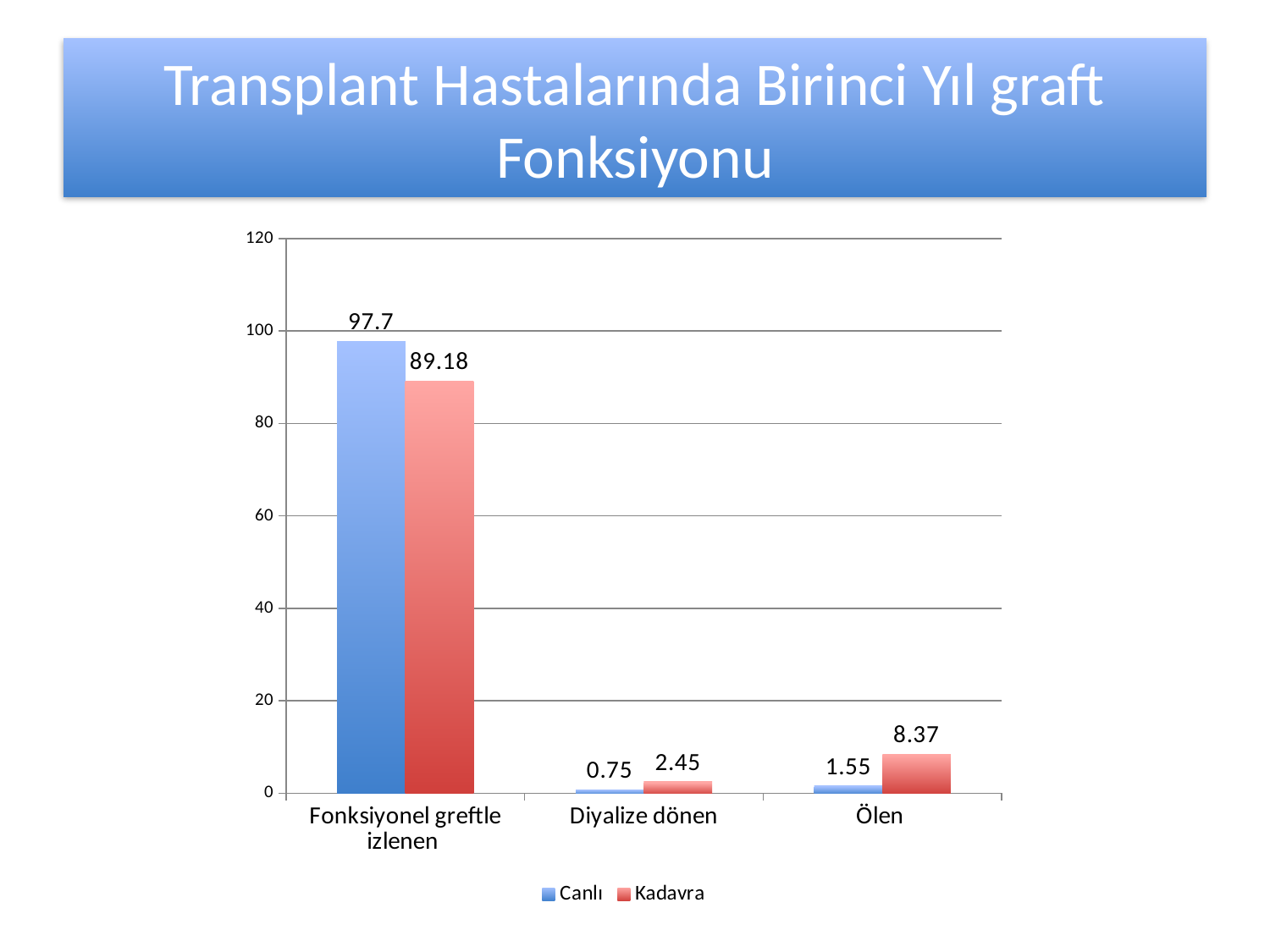
What is the Kadavra value for Ölen? 8.37 What kind of chart is shown on the slide? Bar chart What is the Canlı value for Diyalize dönen? 0.75 How many series does the legend list? 2 Which category has the lowest Canlı value? Diyalize dönen For Ölen, which series has the larger value, Canlı or Kadavra? Kadavra What is the Canlı value for Fonksiyonel greftle izlenen? 97.7 How many categories are shown on the x axis? 3 What is the difference between the Canlı and Kadavra values for Fonksiyonel greftle izlenen? 8.52 What is the Kadavra value for Fonksiyonel greftle izlenen? 89.18 Which category has the highest Kadavra value? Fonksiyonel greftle izlenen Is the Kadavra value for Fonksiyonel greftle izlenen greater or less than 80? greater